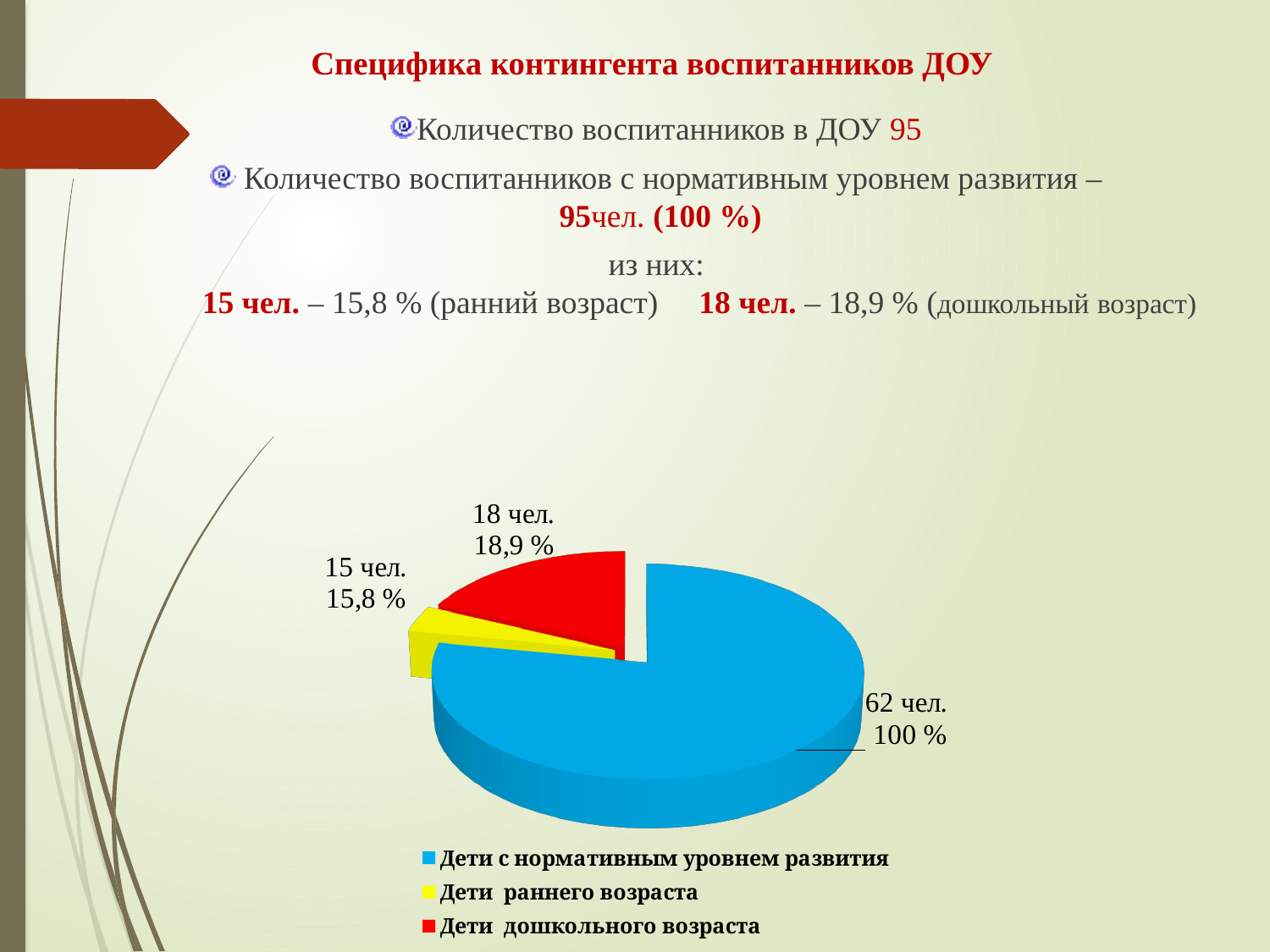
How many entries does the legend of the pie chart list? 3 What percentage is printed for the slice "Дети дошкольного возраста"? 18,9 % How many children are shown for the slice "Дети дошкольного возраста"? 18 чел. Which slice of the pie chart is the smallest? Дети раннего возраста How many children are shown for the slice "Дети раннего возраста"? 15 чел. How many slices does the pie chart have? 3 What is the difference in the number of children between "Дети дошкольного возраста" and "Дети раннего возраста"? 3 чел. How many children are shown for the slice "Дети с нормативным уровнем развития"? 62 чел. Which slice is larger: "Дети дошкольного возраста" or "Дети раннего возраста"? Дети дошкольного возраста What kind of chart is shown on the slide? pie chart What percentage is printed for the slice "Дети раннего возраста"? 15,8 % Which slice of the pie chart is the largest? Дети с нормативным уровнем развития